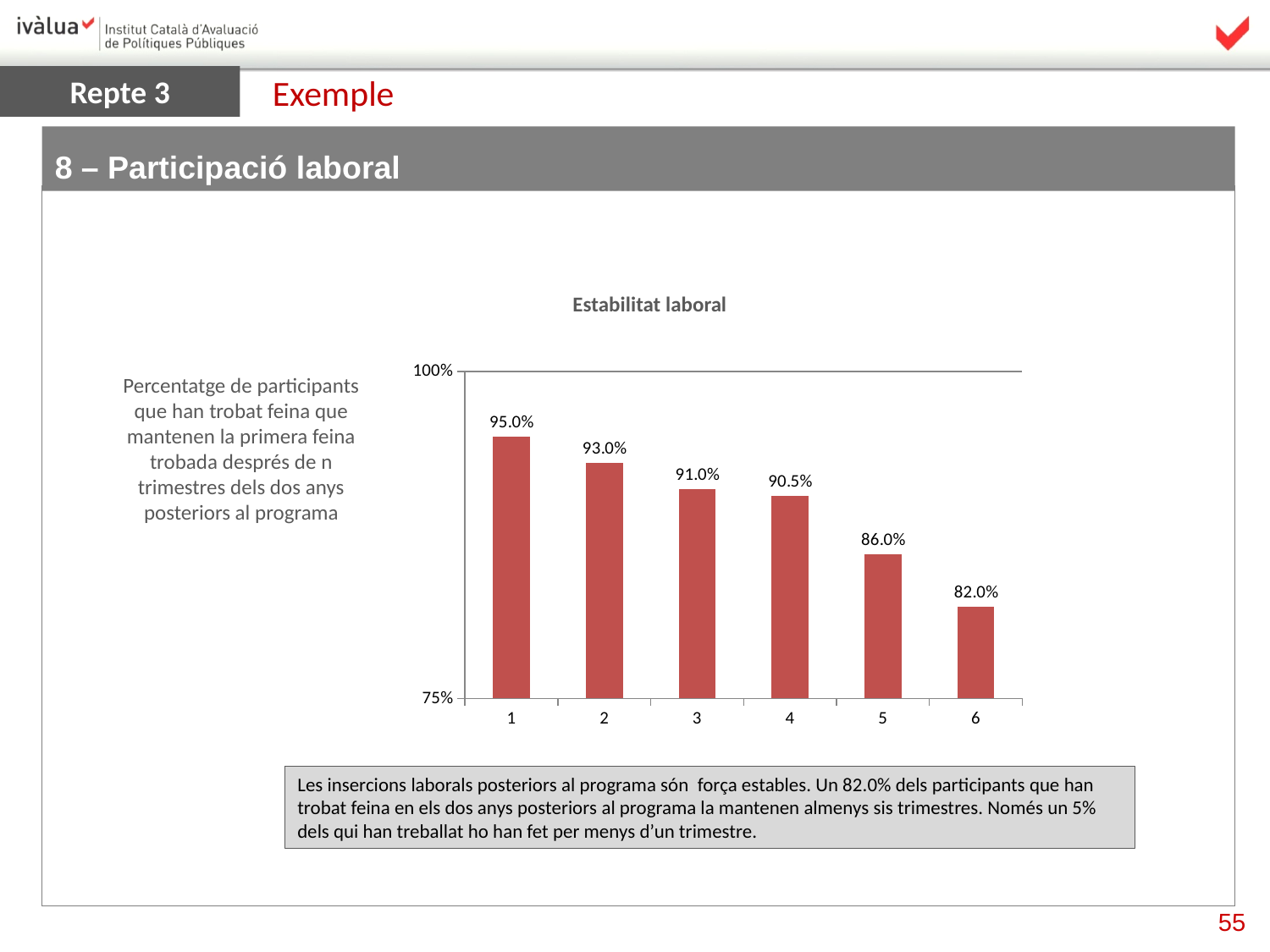
How many categories are shown on the x axis of the Estabilitat laboral chart? 6 Which category has the highest value in the Estabilitat laboral chart? 1 Which category has the lowest value in the Estabilitat laboral chart? 6 What kind of chart is the Estabilitat laboral chart? bar chart What is the difference between the values for category 2 and category 3 in the Estabilitat laboral chart? 2.0% Which is larger in the Estabilitat laboral chart, the value for category 3 or category 5? 3 What is the value for category 1 in the Estabilitat laboral chart? 95.0% What is the value for category 6 in the Estabilitat laboral chart? 82.0% What is the value for category 4 in the Estabilitat laboral chart? 90.5% Do the values in the Estabilitat laboral chart rise or fall from category 1 to category 6? fall What is the difference between the values for category 1 and category 6 in the Estabilitat laboral chart? 13.0% What is the title of the chart on the slide? Estabilitat laboral